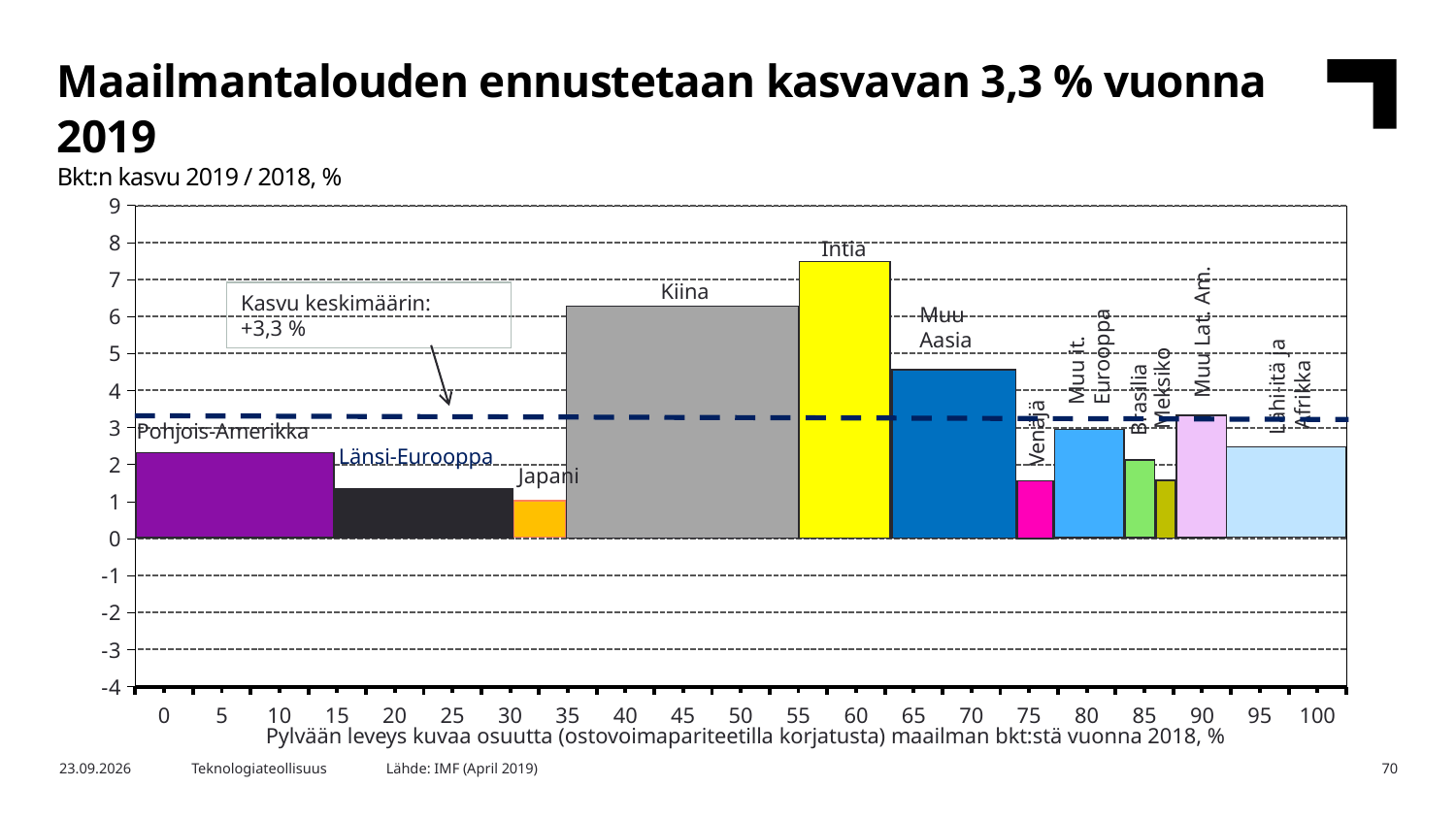
Which has the higher GDP growth, Intia or Kiina? Intia Is the value for Pohjois-Amerikka greater or less than 3? less Which region has the highest GDP growth in the chart? Intia Is the value for Kiina greater or less than 5? greater What average growth rate is marked by the dashed line in the chart? +3,3 % Is the value for Muu Aasia greater or less than 4? greater According to the note below the x axis, what does the width of each bar represent? Share of world GDP in 2018 (PPP-adjusted) Which has the higher GDP growth, Kiina or Muu Aasia? Kiina What kind of chart is shown on the slide? bar chart How many regions are shown as bars in the chart? 12 Which region has the lowest GDP growth in the chart? Japani